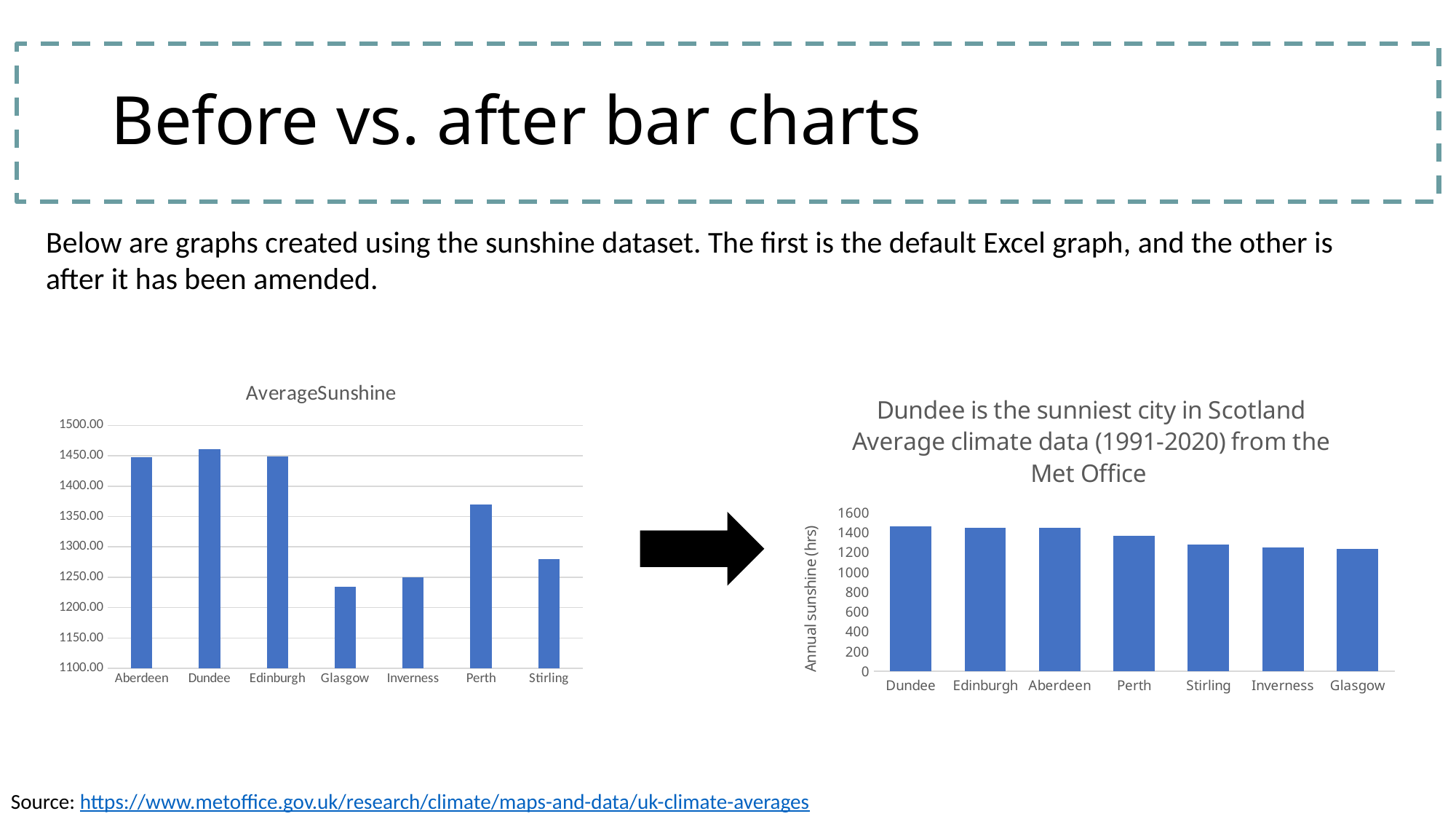
How many cities are shown in the left chart titled AverageSunshine? 7 In the left chart titled AverageSunshine, which is larger, the value for Perth or the value for Inverness? Perth In the left chart titled AverageSunshine, which city has the lowest value? Glasgow What kind of chart is the right-hand chart on the slide? bar chart In the left chart titled AverageSunshine, is the value for Perth greater or less than 1350? greater In the left chart titled AverageSunshine, is the value for Glasgow greater or less than 1250? less In the right-hand chart, which is larger, the value for Dundee or the value for Glasgow? Dundee In the left chart titled AverageSunshine, which city has the highest value? Dundee In the right-hand chart, do the values rise or fall from left to right along the x axis? fall In the left chart titled AverageSunshine, is the value for Stirling greater or less than 1300? less What is the y-axis label of the right-hand chart? Annual sunshine (hrs)